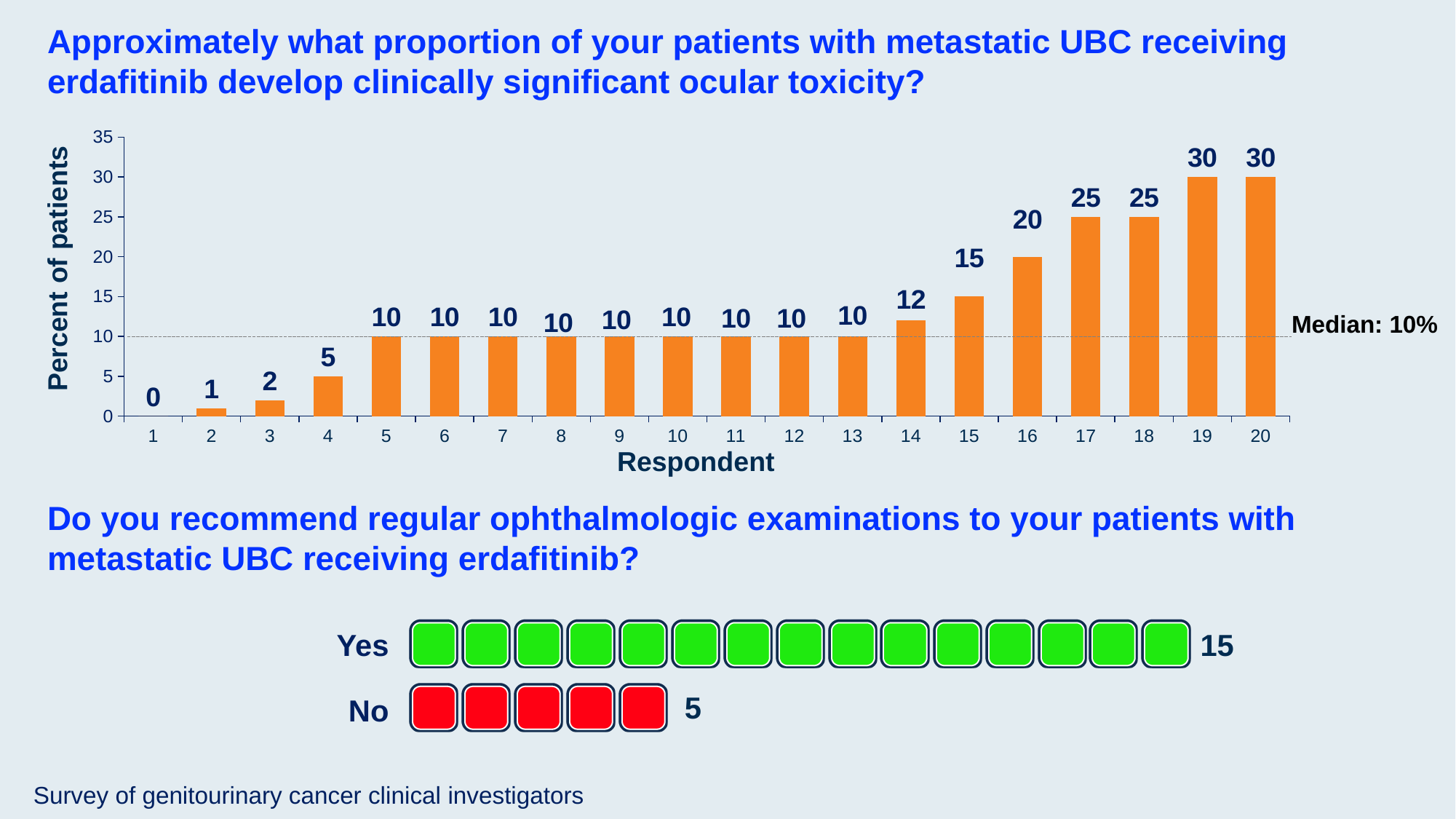
In the top bar chart on ocular toxicity, what is the highest value shown? 30 In the top bar chart on ocular toxicity, how many respondents are shown on the x axis? 20 In the top bar chart on ocular toxicity, what value is shown for respondent 14? 12 In the top bar chart on ocular toxicity, which is larger: the value for respondent 3 or respondent 4? Respondent 4 In the top bar chart on ocular toxicity, what is the difference between the values for respondent 17 and respondent 15? 10 What type of chart is the top chart on ocular toxicity? Bar chart In the top bar chart on ocular toxicity, do the values rise or fall from respondent 1 to respondent 20? Rise In the bottom chart on recommending ophthalmologic examinations, how many respondents answered Yes? 15 In the top bar chart on ocular toxicity, what median value is labelled by the dashed line? 10% In the top bar chart on ocular toxicity, what value is shown for respondent 16? 20 In the top bar chart on ocular toxicity, what value is shown for respondent 4? 5 In the top bar chart on ocular toxicity, which respondent has the lowest value? 1